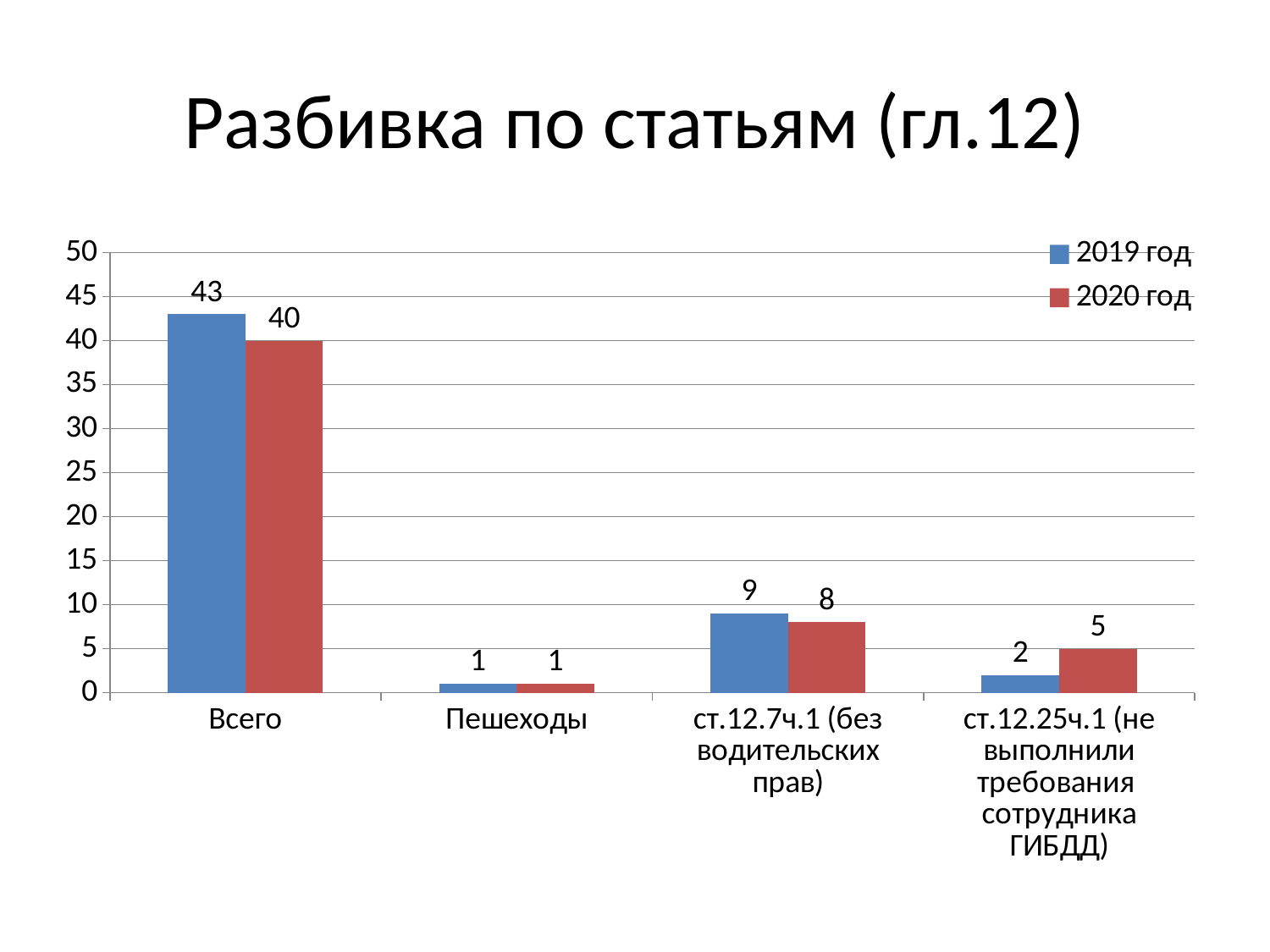
What kind of chart is shown on the slide? bar chart What is the value for ст.12.7ч.1 (без водительских прав) in the 2020 год series? 8 Which category has the lowest value in the 2020 год series? Пешеходы What is the value for Всего in the 2020 год series? 40 Which is larger for ст.12.25ч.1 (не выполнили требования сотрудника ГИБДД): the 2019 год value or the 2020 год value? 2020 год Which category has the highest value in the 2019 год series? Всего How many series does the legend list? 2 How many categories are shown on the x axis? 4 What is the value for ст.12.25ч.1 (не выполнили требования сотрудника ГИБДД) in the 2019 год series? 2 What is the value for Всего in the 2019 год series? 43 What is the difference between the 2019 год and 2020 год values for Всего? 3 What is the title of the slide? Разбивка по статьям (гл.12)